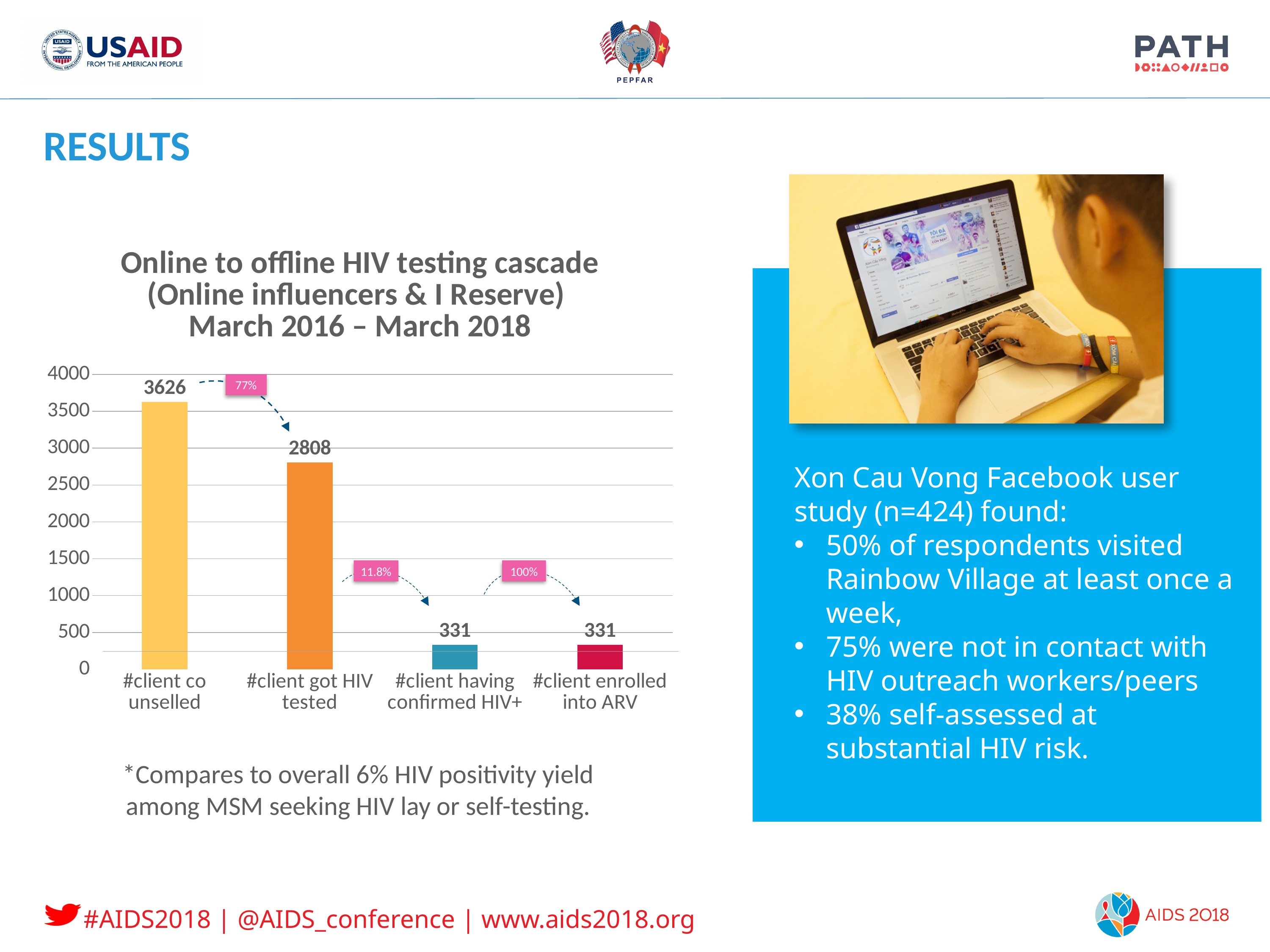
What kind of chart is this? bar chart Which category has the highest value? #client counselled What is the value for #client got HIV tested? 2808 How many categories are shown on the x axis? 4 What percentage is shown on the arrow between #client having confirmed HIV+ and #client enrolled into ARV? 100% What percentage is shown on the arrow between #client counselled and #client got HIV tested? 77% Do the values rise or fall from left to right along the x axis? fall What is the difference between #client counselled and #client got HIV tested? 818 What is the value for #client counselled? 3626 Which is larger, #client got HIV tested or #client enrolled into ARV? #client got HIV tested What is the difference between #client got HIV tested and #client having confirmed HIV+? 2477 What is the value for #client having confirmed HIV+? 331